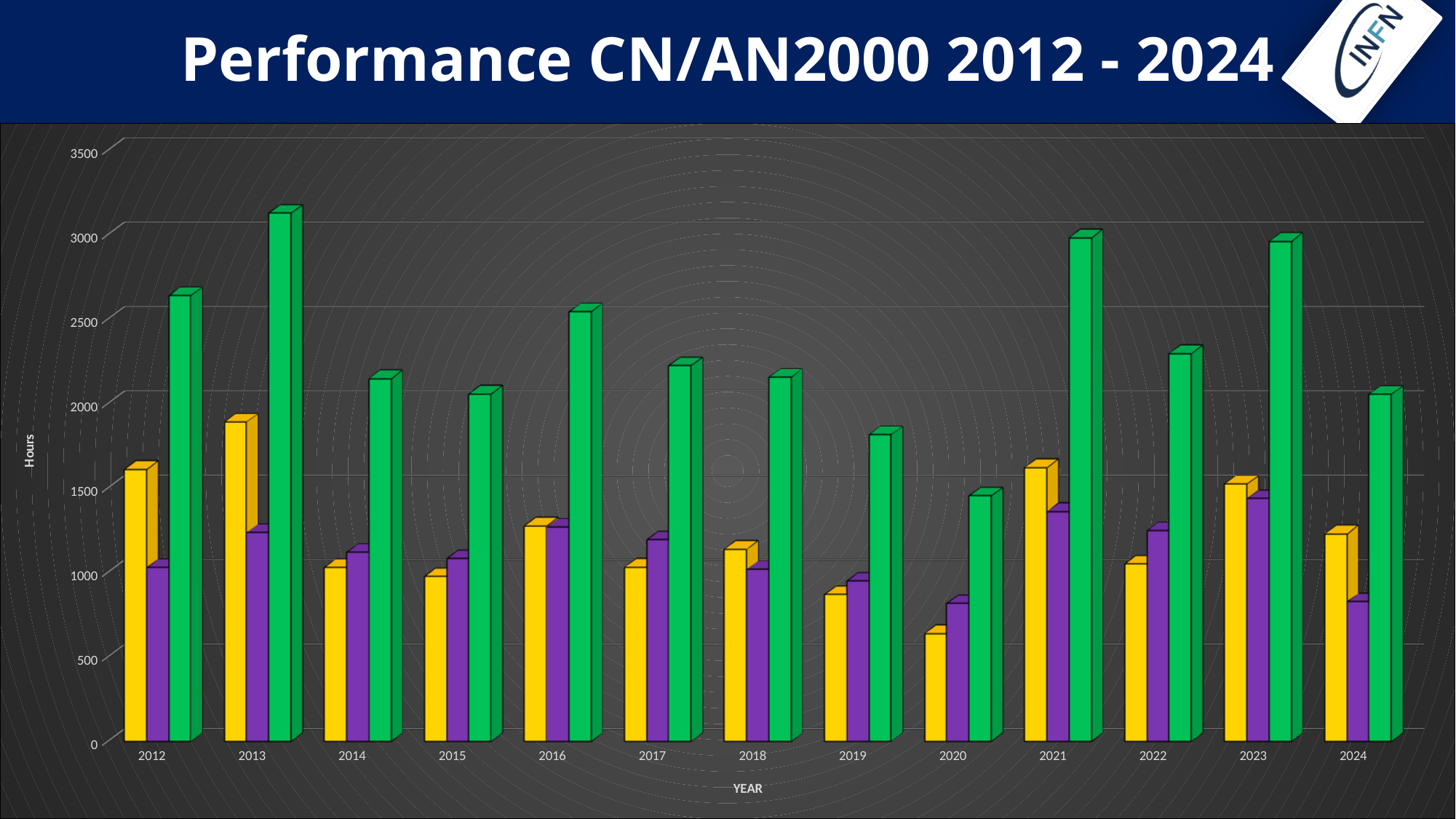
In which year is the yellow bar the shortest? 2020 How many years are shown along the x axis? 13 Do the green bars rise or fall from 2017 to 2020? fall What is the label on the vertical axis? Hours In which year is the yellow bar the tallest? 2013 Is the yellow bar for 2020 greater or less than 1000? less What kind of chart is shown on the slide? bar chart In which year is the green bar the tallest? 2013 In which year is the green bar the shortest? 2020 Which is taller in 2013, the yellow bar or the purple bar? the yellow bar Is the green bar for 2013 greater or less than 3000? greater